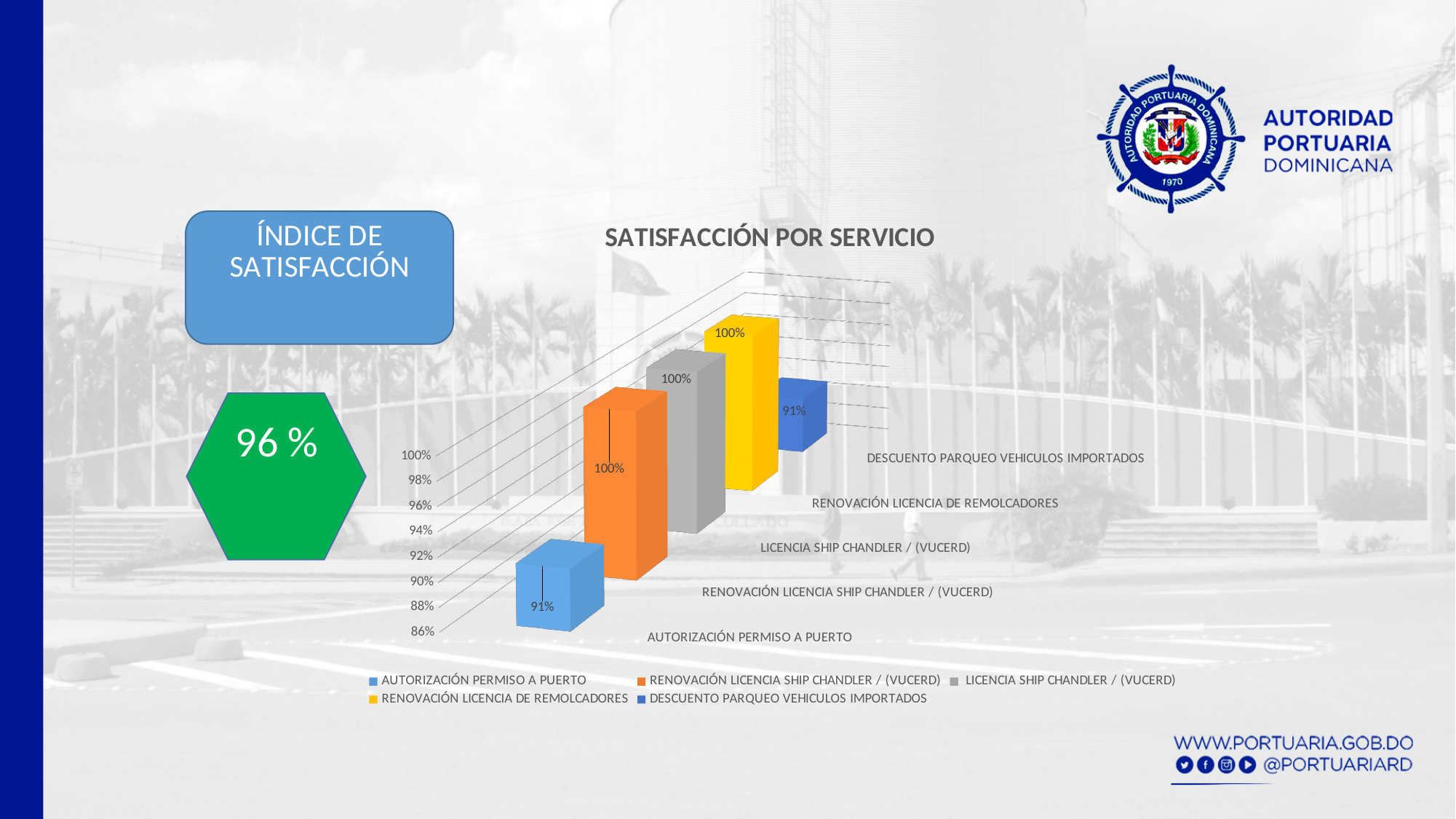
How many entries does the chart legend list? 5 Is the value for DESCUENTO PARQUEO VEHICULOS IMPORTADOS greater or less than 96%? less What is the value for DESCUENTO PARQUEO VEHICULOS IMPORTADOS? 91% What is the difference between the values for RENOVACIÓN LICENCIA DE REMOLCADORES and DESCUENTO PARQUEO VEHICULOS IMPORTADOS? 9% What is the value for RENOVACIÓN LICENCIA SHIP CHANDLER / (VUCERD)? 100% Which has the larger value, AUTORIZACIÓN PERMISO A PUERTO or LICENCIA SHIP CHANDLER / (VUCERD)? LICENCIA SHIP CHANDLER / (VUCERD) What is the value for RENOVACIÓN LICENCIA DE REMOLCADORES? 100% What is the title of the chart? SATISFACCIÓN POR SERVICIO What is the value for LICENCIA SHIP CHANDLER / (VUCERD)? 100% What is the value for AUTORIZACIÓN PERMISO A PUERTO? 91% What kind of chart is shown on the slide? bar chart How many categories are shown in the chart? 5